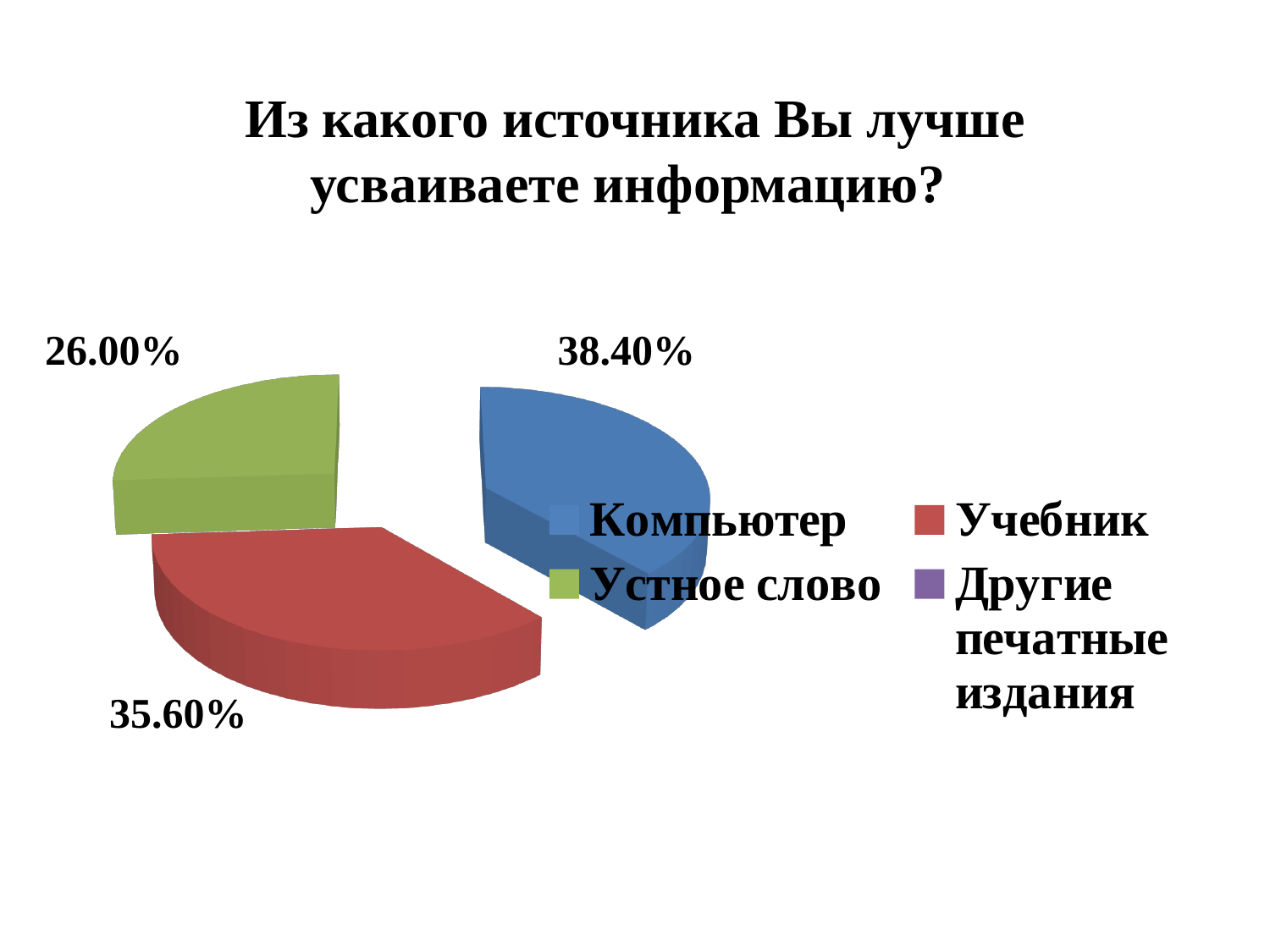
What percentage is shown for Компьютер? 38.40% What percentage is shown for Учебник? 35.60% What is the difference between the shares for Компьютер and Учебник? 2.80% What kind of chart is shown on the slide? Pie chart Which category has the largest share of the pie? Компьютер What colour is the slice for Учебник? Red What is the difference between the shares for Учебник and Устное слово? 9.60% How many entries does the chart legend list? 4 What percentage is shown for Устное слово? 26.00% What is the difference between the shares for Компьютер and Устное слово? 12.40% Which of the three labelled slices is the smallest? Устное слово Which is larger, the share for Учебник or the share for Устное слово? Учебник